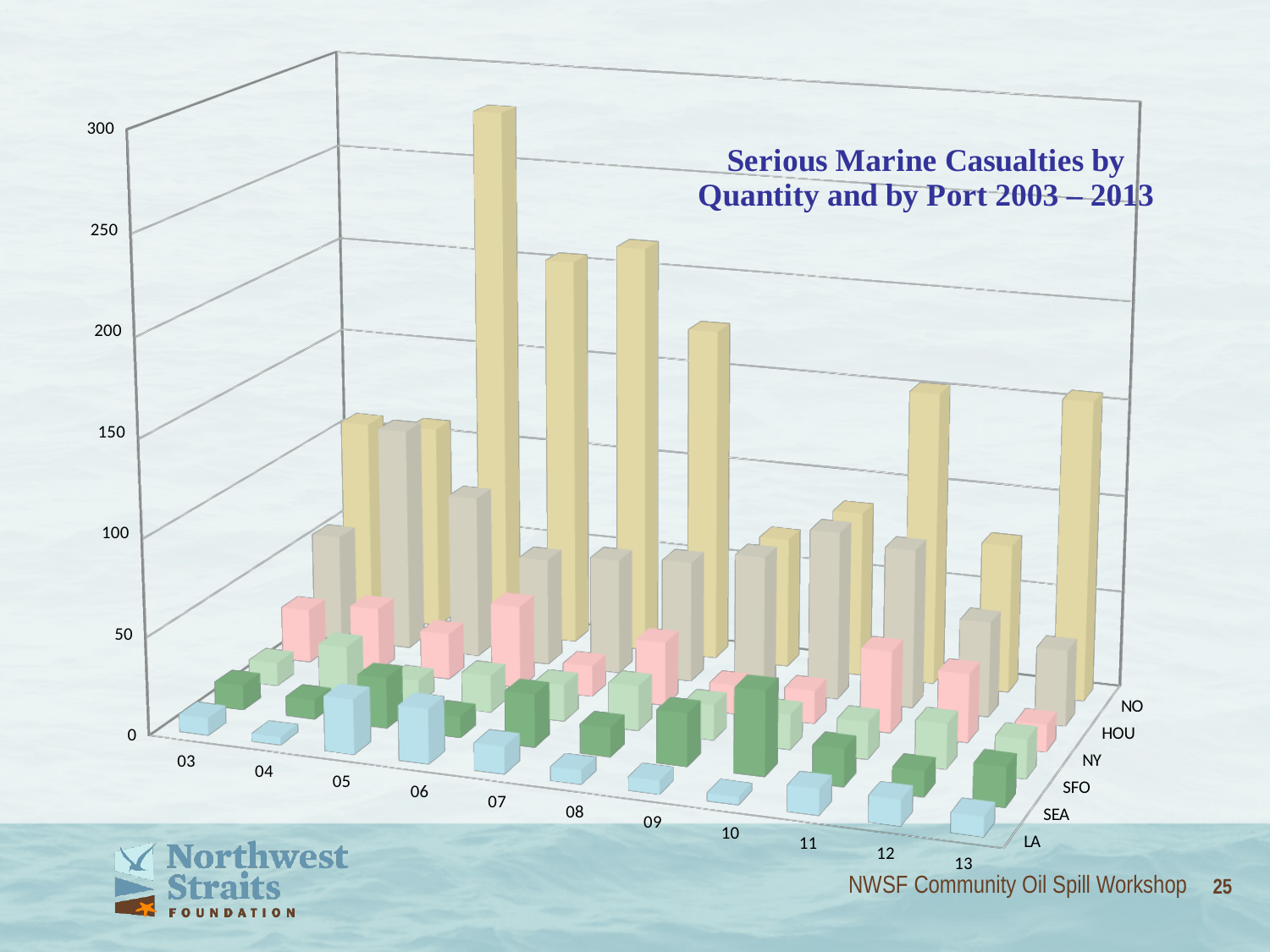
What kind of chart is shown on the slide? 3D bar chart Which port has the tallest bar in the chart? NO What is the title of the chart? Serious Marine Casualties by Quantity and by Port 2003 – 2013 In which year does the NO port reach its highest value? 05 Do the values for NO rise or fall from 07 to 10? fall How many ports are plotted in the chart? 6 Is the value for LA in 08 greater or less than 50? less How many years are shown along the x axis of the chart? 11 Which is larger, the value for NO in 07 or the value for NO in 10? NO in 07